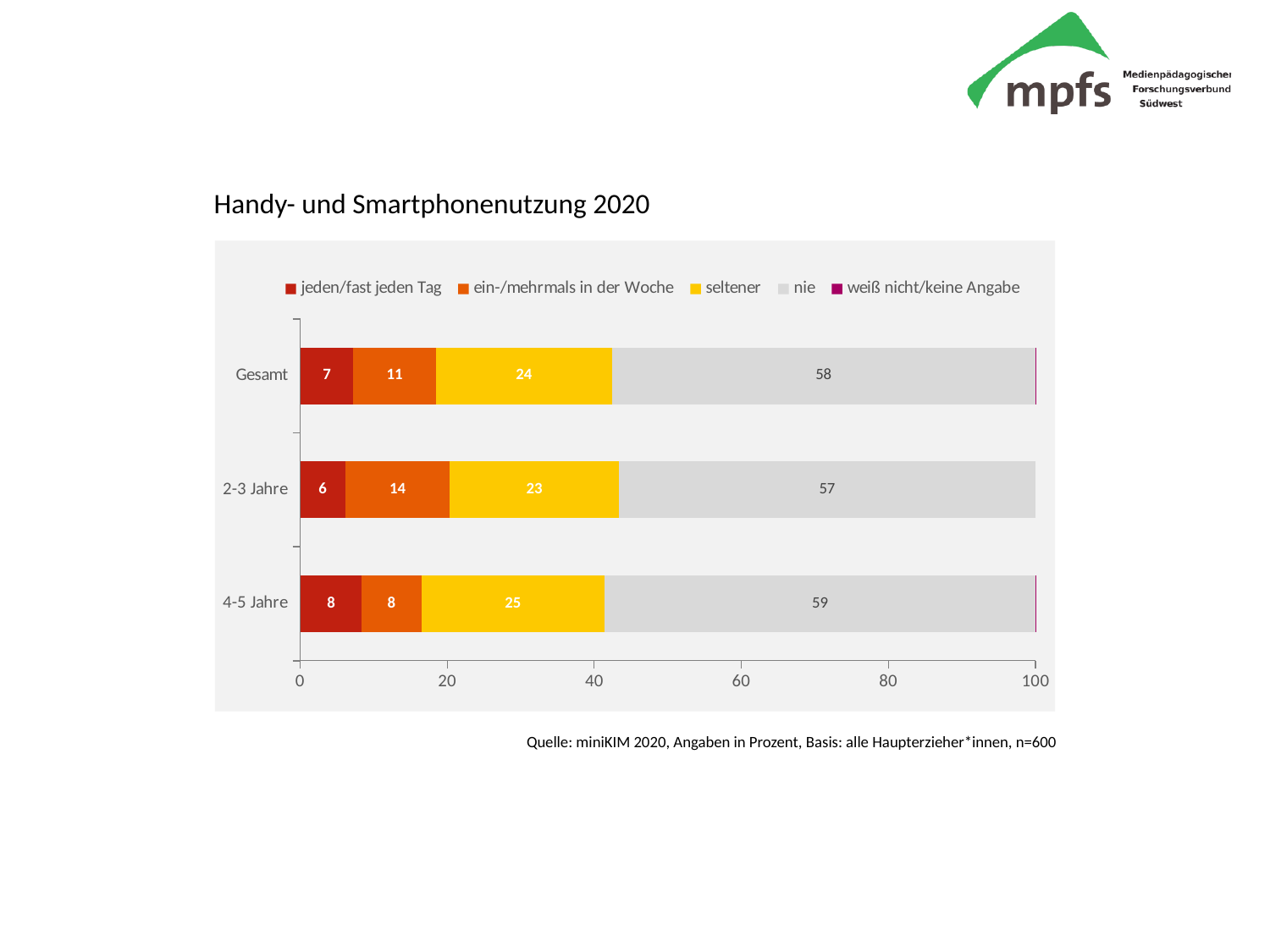
What is the title of the chart? Handy- und Smartphonenutzung 2020 What is the value for "seltener" in the 4-5 Jahre bar? 25 Which category has the lowest value for "ein-/mehrmals in der Woche"? 4-5 Jahre How many series does the legend list? 5 What kind of chart is shown? Stacked bar chart What is the value for "ein-/mehrmals in der Woche" in the 2-3 Jahre bar? 14 Is the "seltener" value larger for 2-3 Jahre or for 4-5 Jahre? 4-5 Jahre How many categories are shown on the vertical axis? 3 What is the value for "nie" in the Gesamt bar? 58 Which age group has the highest value for "jeden/fast jeden Tag"? 4-5 Jahre What is the total of the labelled segments in the Gesamt bar? 100 What is the difference between the "nie" values for 4-5 Jahre and 2-3 Jahre? 2